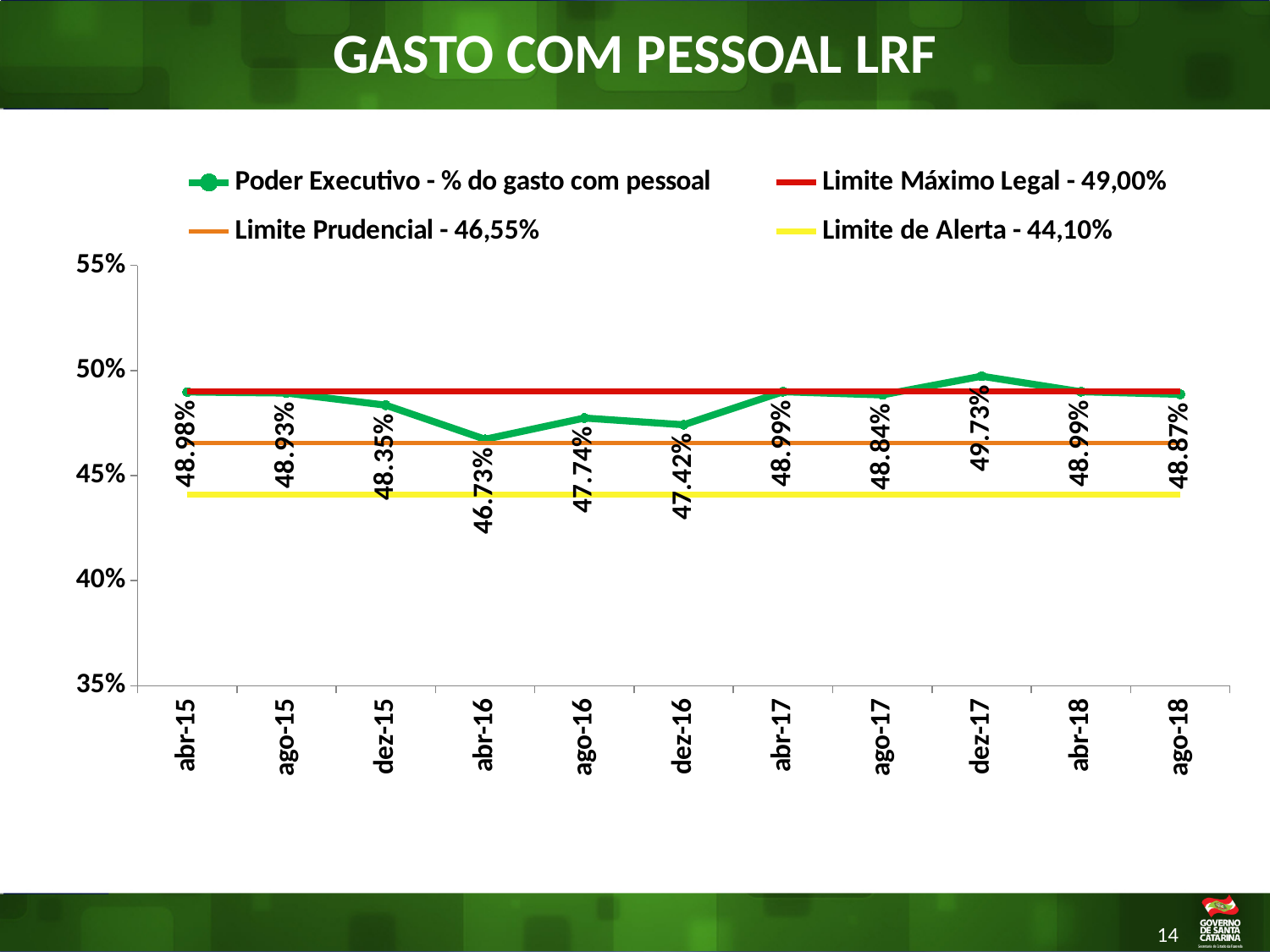
What is the Poder Executivo value for dez-17? 49.73% What kind of chart is shown on the slide? line chart What is the Poder Executivo value for ago-18? 48.87% Which is larger, the Poder Executivo value for abr-17 or for ago-17? abr-17 In which period is the Poder Executivo percentage highest? dez-17 What is the Poder Executivo value for abr-16? 46.73% How many series does the legend list? 4 Is the Poder Executivo value for abr-16 greater or less than 45%? greater How many periods are shown on the x axis? 11 What is the difference between the Poder Executivo values for dez-17 and abr-16? 3.00 percentage points Does the Poder Executivo percentage rise or fall from dez-15 to abr-16? fall In which period is the Poder Executivo percentage lowest? abr-16